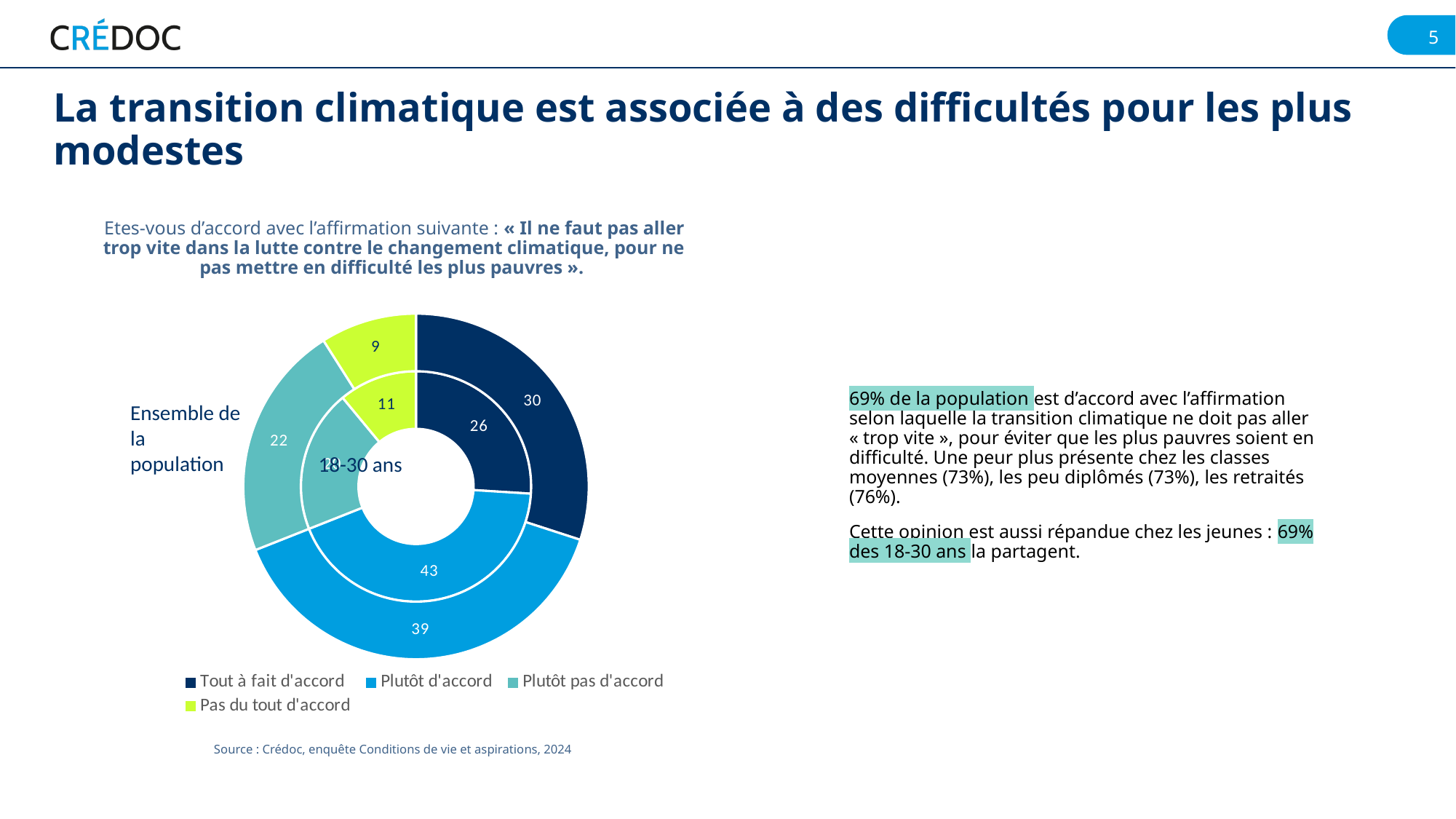
How many entries does the chart legend list? 4 What kind of chart is shown on the slide? doughnut chart What is the value for "Plutôt pas d'accord" in the outer ring (Ensemble de la population)? 22 Which response category has the largest share in the outer ring (Ensemble de la population)? Plutôt d'accord What is the value for "Plutôt d'accord" in the outer ring (Ensemble de la population)? 39 What is the value for "Pas du tout d'accord" in the outer ring (Ensemble de la population)? 9 Which response category has the smallest share in the outer ring (Ensemble de la population)? Pas du tout d'accord What is the value for "Tout à fait d'accord" in the outer ring (Ensemble de la population)? 30 What is the difference between "Plutôt d'accord" and "Tout à fait d'accord" in the outer ring (Ensemble de la population)? 9 Which is larger in the inner ring (18-30 ans): "Plutôt d'accord" or "Pas du tout d'accord"? Plutôt d'accord What is the value for "Tout à fait d'accord" in the inner ring (18-30 ans)? 26 What is the value for "Plutôt d'accord" in the inner ring (18-30 ans)? 43